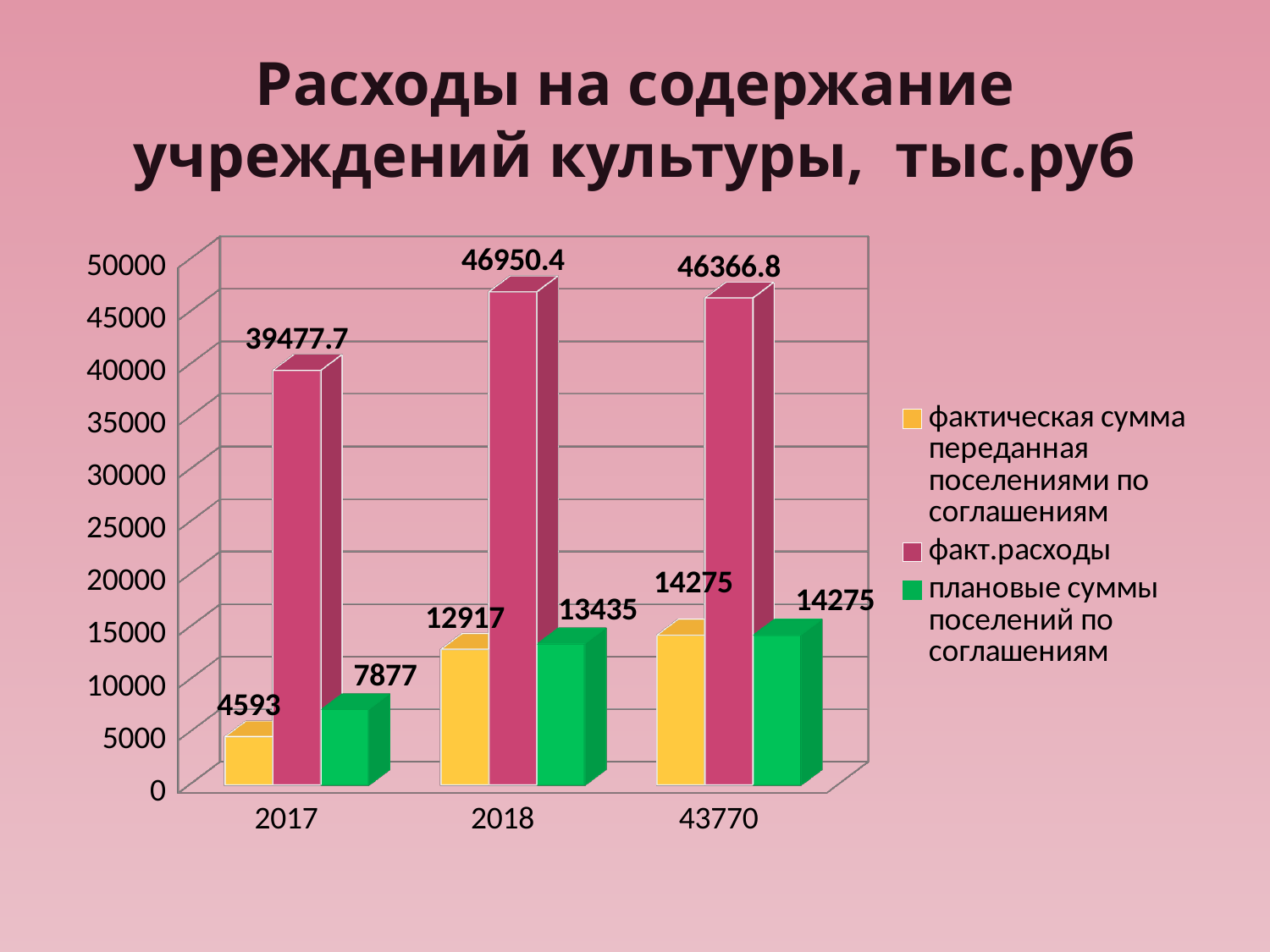
What is the value of фактическая сумма переданная поселениями по соглашениям for 2017? 4593 What is the difference between факт.расходы for 2018 and for 2017? 7472.7 What is the value of факт.расходы for 2017? 39477.7 In which category is фактическая сумма переданная поселениями по соглашениям lowest? 2017 What is the value of плановые суммы поселений по соглашениям for 2018? 13435 What is the value of факт.расходы for the category labelled 43770? 46366.8 What is the title of the chart? Расходы на содержание учреждений культуры, тыс.руб For 2018, which is larger: фактическая сумма переданная поселениями по соглашениям or плановые суммы поселений по соглашениям? плановые суммы поселений по соглашениям In which category is факт.расходы highest? 2018 How many series does the legend list? 3 How many categories are shown on the x axis? 3 What kind of chart is shown on the slide? bar chart